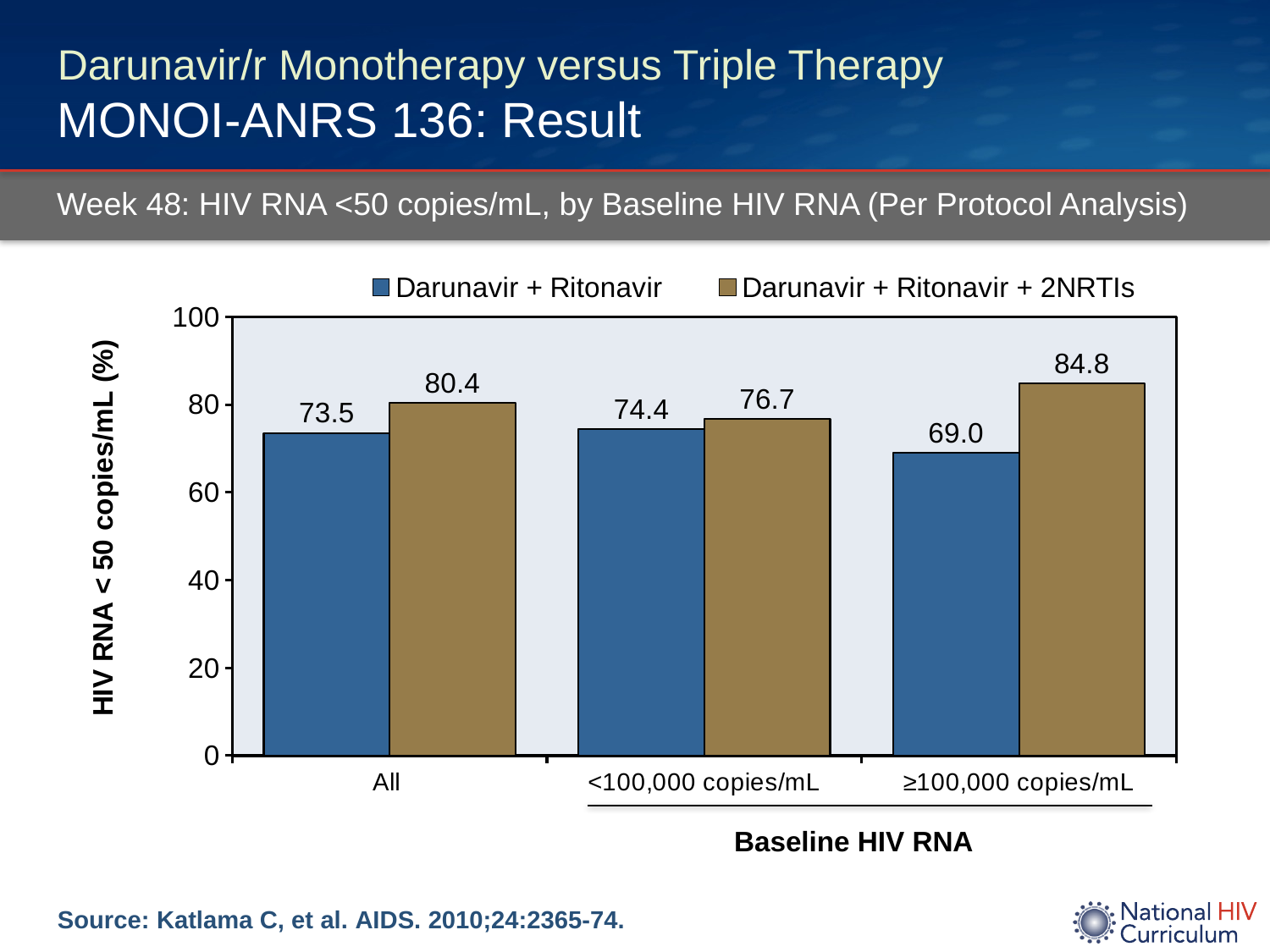
What kind of chart is shown on the slide? Bar chart How many series does the legend list? 2 What is the value for Darunavir + Ritonavir + 2NRTIs in the ≥100,000 copies/mL group? 84.8 What is the value for Darunavir + Ritonavir in the <100,000 copies/mL group? 74.4 How many baseline HIV RNA categories are shown on the x axis? 3 In the <100,000 copies/mL group, which series has the larger value? Darunavir + Ritonavir + 2NRTIs Which baseline HIV RNA group has the highest value for Darunavir + Ritonavir + 2NRTIs? ≥100,000 copies/mL What is the value for Darunavir + Ritonavir in the All group? 73.5 Which baseline HIV RNA group has the lowest value for Darunavir + Ritonavir? ≥100,000 copies/mL Is the value for Darunavir + Ritonavir in the ≥100,000 copies/mL group greater or less than 80? less What is the difference between Darunavir + Ritonavir + 2NRTIs and Darunavir + Ritonavir in the ≥100,000 copies/mL group? 15.8 What is the difference between Darunavir + Ritonavir + 2NRTIs and Darunavir + Ritonavir in the All group? 6.9